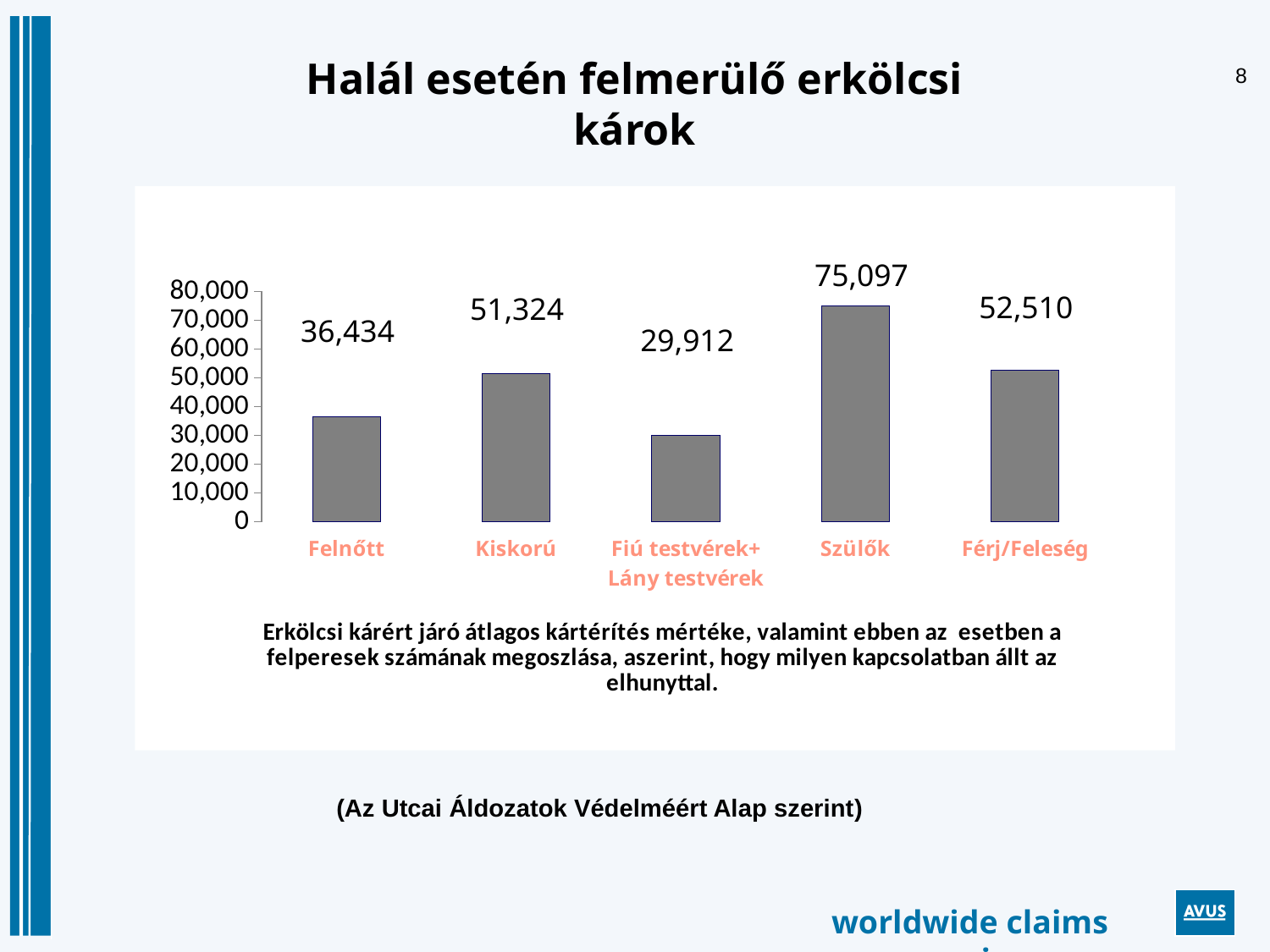
What kind of chart is shown on the slide? bar chart Which is larger, the value for Kiskorú or the value for Felnőtt? Kiskorú What is the value for Férj/Feleség? 52,510 Is the value for Felnőtt greater or less than 40,000? less Which category has the highest value? Szülők What is the value for Szülők? 75,097 What is the value for Fiú testvérek+ Lány testvérek? 29,912 What is the difference between the values for Kiskorú and Fiú testvérek+ Lány testvérek? 21,412 Which category has the lowest value? Fiú testvérek+ Lány testvérek What is the value for Felnőtt? 36,434 What is the difference between the values for Szülők and Felnőtt? 38,663 How many categories are shown in the chart? 5